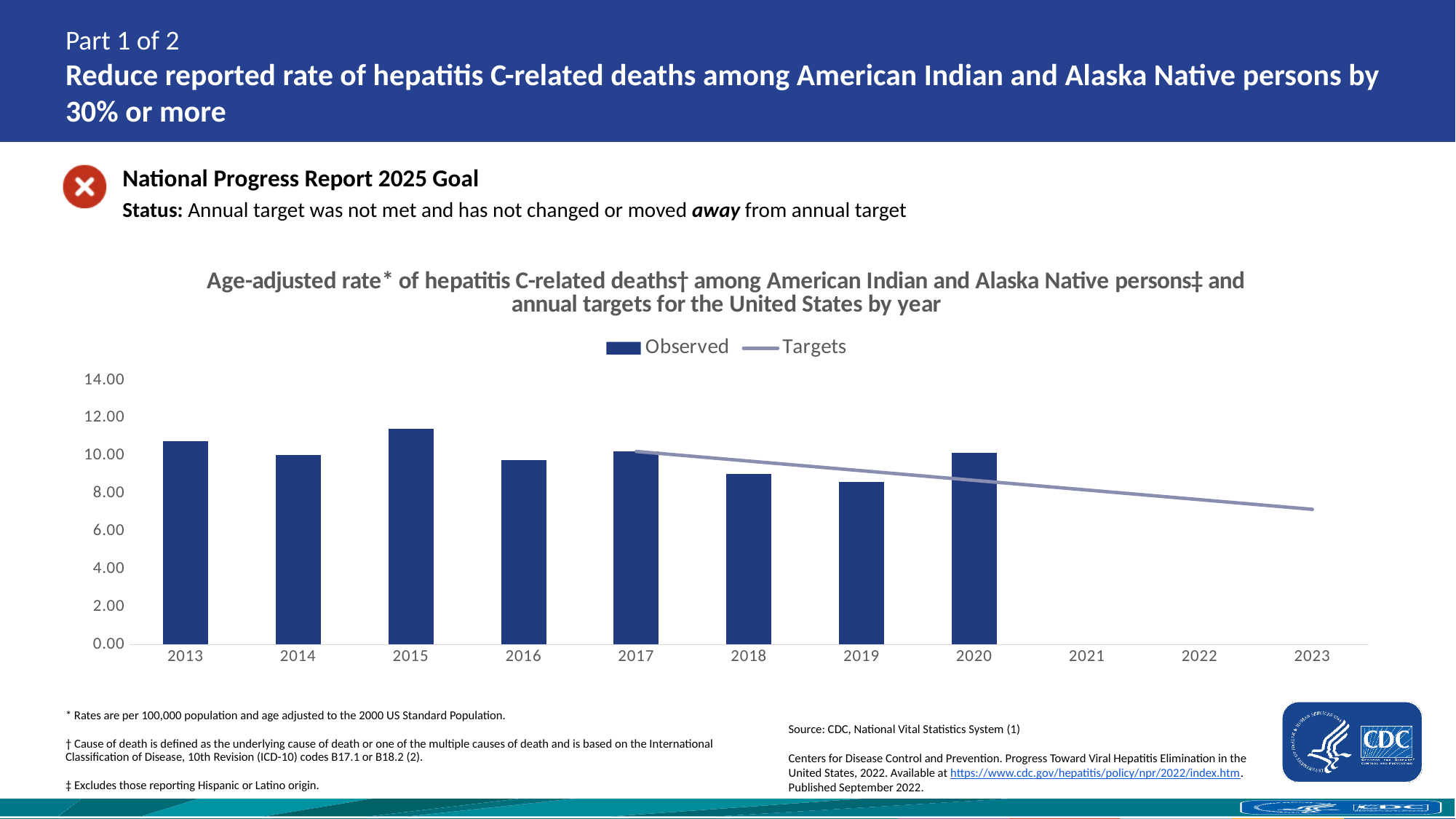
Which year has the larger Observed value, 2013 or 2014? 2013 Which year has the lowest Observed bar? 2019 Is the Targets value for 2023 greater or less than 8.00? less What are the two series named in the legend? Observed and Targets How many years have an Observed bar plotted? 8 How many series does the legend list? 2 Is the Observed value for 2018 greater or less than 10.00? less What kind of chart is shown on the slide? Bar chart with a line Is the Observed value for 2015 greater or less than 10.00? greater Does the Targets line rise or fall from 2017 to 2023? Fall Which year has the highest Observed bar? 2015